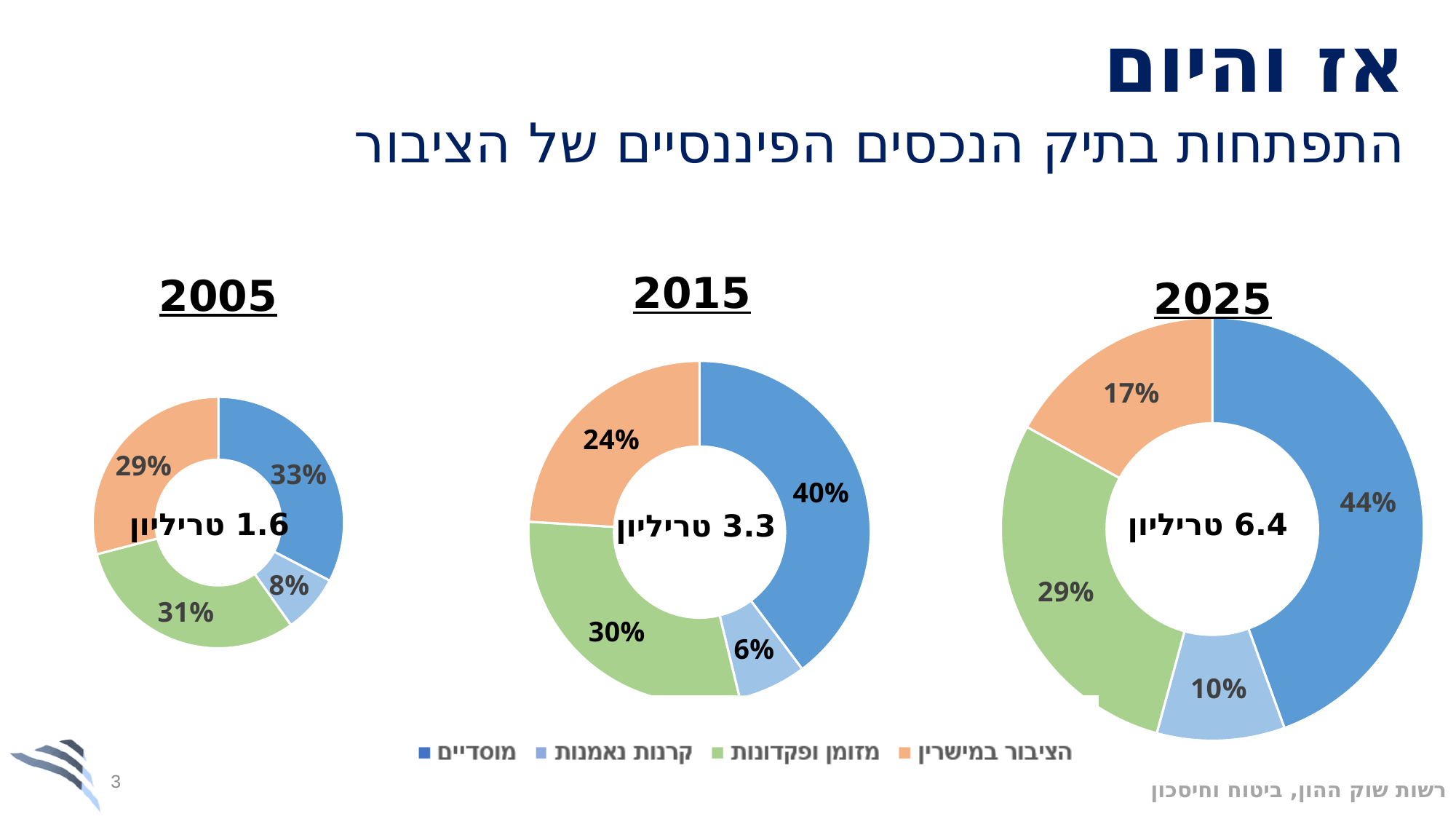
In the 2025 chart, what share is labelled for the הציבור במישרין (orange) slice? 17% In the 2005 chart, what share is labelled for the מוסדיים (blue) slice? 33% In the 2005 chart, which category has the smallest share? קרנות נאמנות How many series does the legend list? 4 In the 2015 chart, what is the difference between the מוסדיים share and the מזומן ופקדונות share? 10% In the 2015 chart, what share is labelled for the קרנות נאמנות (light blue) slice? 6% What kind of chart is used for 2005, 2015 and 2025? Donut (pie) chart In the 2025 chart, which category has the largest share? מוסדיים How does the מוסדיים share change from the 2005 chart to the 2025 chart? It rises (33% to 44%) What total value is printed in the centre of the 2015 chart? 3.3 טריליון In the 2025 chart, which is larger: the מזומן ופקדונות share or the הציבור במישרין share? מזומן ופקדונות How many charts are shown on the slide? 3